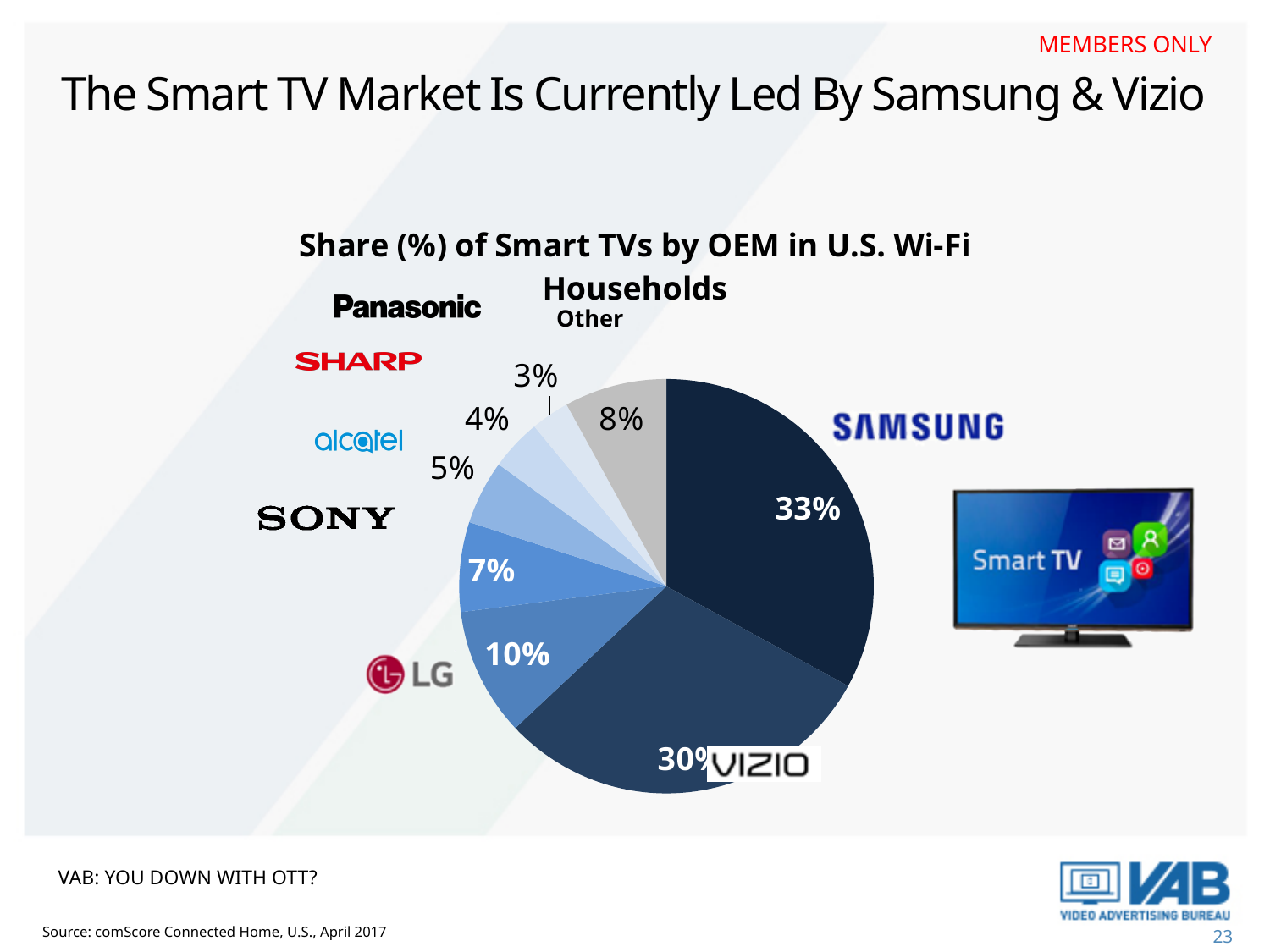
What share of smart TVs does Sony hold according to the pie chart? 7% What share of smart TVs does Vizio hold according to the pie chart? 30% Which has a larger share of smart TVs, LG or Sony? LG By how many percentage points does Samsung's share exceed Vizio's share? 3 percentage points What share is labelled for the 'Other' slice of the pie chart? 8% What is the title of the chart on the slide? Share (%) of Smart TVs by OEM in U.S. Wi-Fi Households What share of smart TVs does Samsung hold according to the pie chart? 33% Which named OEM has the smallest slice of the pie chart? Panasonic What share of smart TVs does LG hold according to the pie chart? 10% What kind of chart is shown on the slide? Pie chart Which OEM has the largest slice of the pie chart? Samsung How many slices does the pie chart have? 8